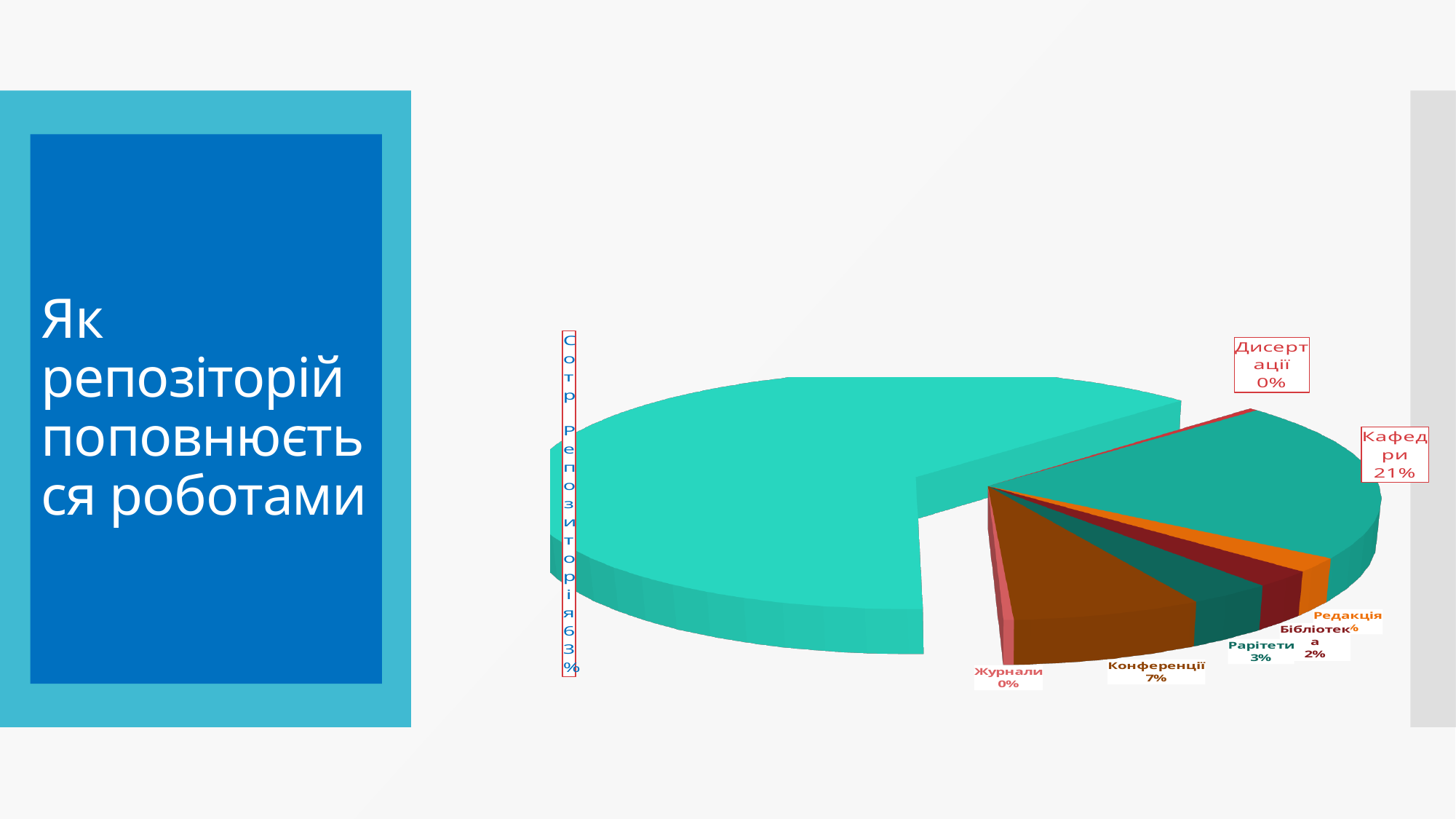
What kind of chart is shown on the slide? Pie chart Which slice has the largest share of the pie? Сотр репозиторія What is the share of the largest slice, Сотр репозиторія? 63% Which has the larger share, Рарітети or Бібліотека? Рарітети How many slices are labelled in the pie chart? 8 What percentage is shown for Бібліотека? 2% What percentage is shown for Журнали? 0% What percentage is shown for Конференції? 7% What percentage is shown for Дисертації? 0% What is the difference in percentage points between Кафедри and Конференції? 14 What percentage is shown for Рарітети? 3% What share of the pie does the Кафедри slice have? 21%